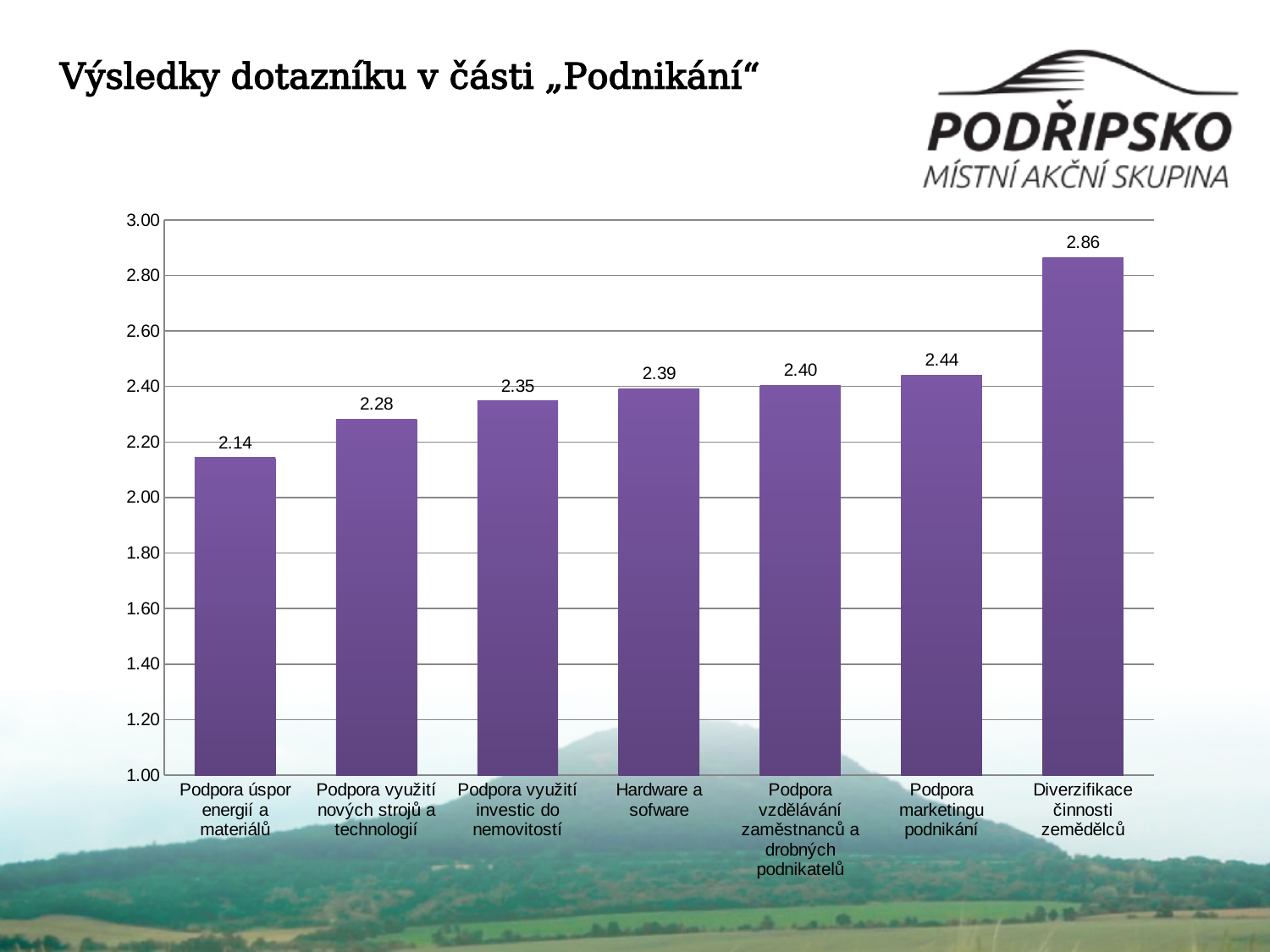
Which category has the lowest value? Podpora úspor energií a materiálů What is the value for "Hardware a sofware"? 2.39 What is the difference between the values for "Diverzifikace činnosti zemědělců" and "Podpora marketingu podnikání"? 0.42 What is the value for "Podpora úspor energií a materiálů"? 2.14 What kind of chart is shown on the slide? bar chart Is the value for "Podpora vzdělávání zaměstnanců a drobných podnikatelů" greater or less than 2.20? greater Which is larger: the value for "Podpora využití nových strojů a technologií" or the value for "Podpora využití investic do nemovitostí"? Podpora využití investic do nemovitostí How many categories are shown in the chart? 7 Which category has the highest value? Diverzifikace činnosti zemědělců What is the value for "Podpora marketingu podnikání"? 2.44 What is the value for "Diverzifikace činnosti zemědělců"? 2.86 Do the values rise or fall from left to right along the x axis? rise